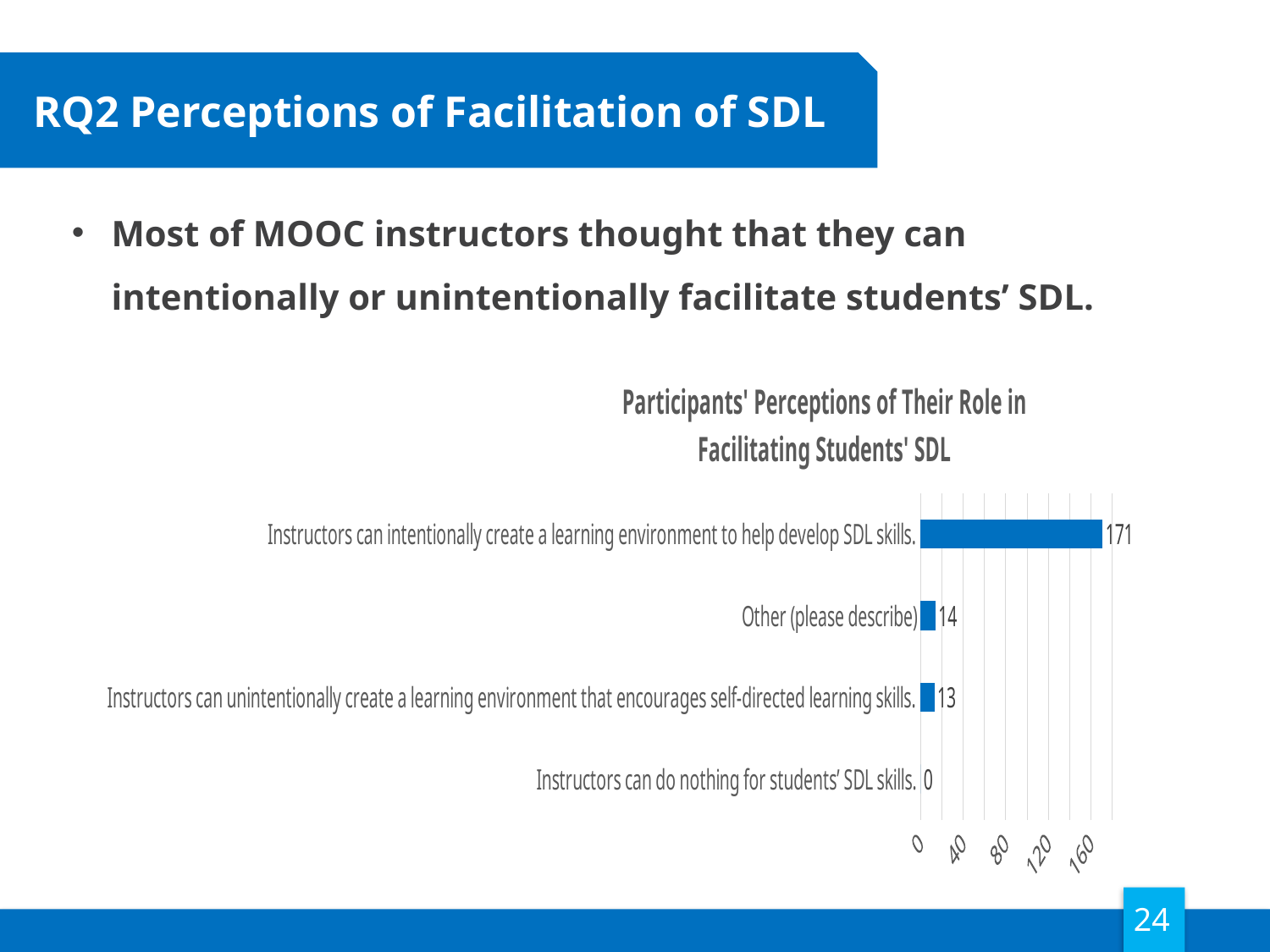
What is the value for "Other (please describe)"? 14 Which is larger: the value for "Other (please describe)" or the value for "Instructors can unintentionally create a learning environment that encourages self-directed learning skills."? Other (please describe) What is the value for "Instructors can intentionally create a learning environment to help develop SDL skills."? 171 Which category has the lowest value? Instructors can do nothing for students' SDL skills. What is the difference between the value for "Instructors can intentionally create a learning environment to help develop SDL skills." and the value for "Other (please describe)"? 157 What is the value for "Instructors can unintentionally create a learning environment that encourages self-directed learning skills."? 13 Is the value for "Instructors can intentionally create a learning environment to help develop SDL skills." greater or less than 160? greater Which category has the highest value? Instructors can intentionally create a learning environment to help develop SDL skills. How many categories are shown in the chart? 4 What kind of chart is shown on the slide? bar chart What is the value for "Instructors can do nothing for students' SDL skills."? 0 What is the title of the chart? Participants' Perceptions of Their Role in Facilitating Students' SDL